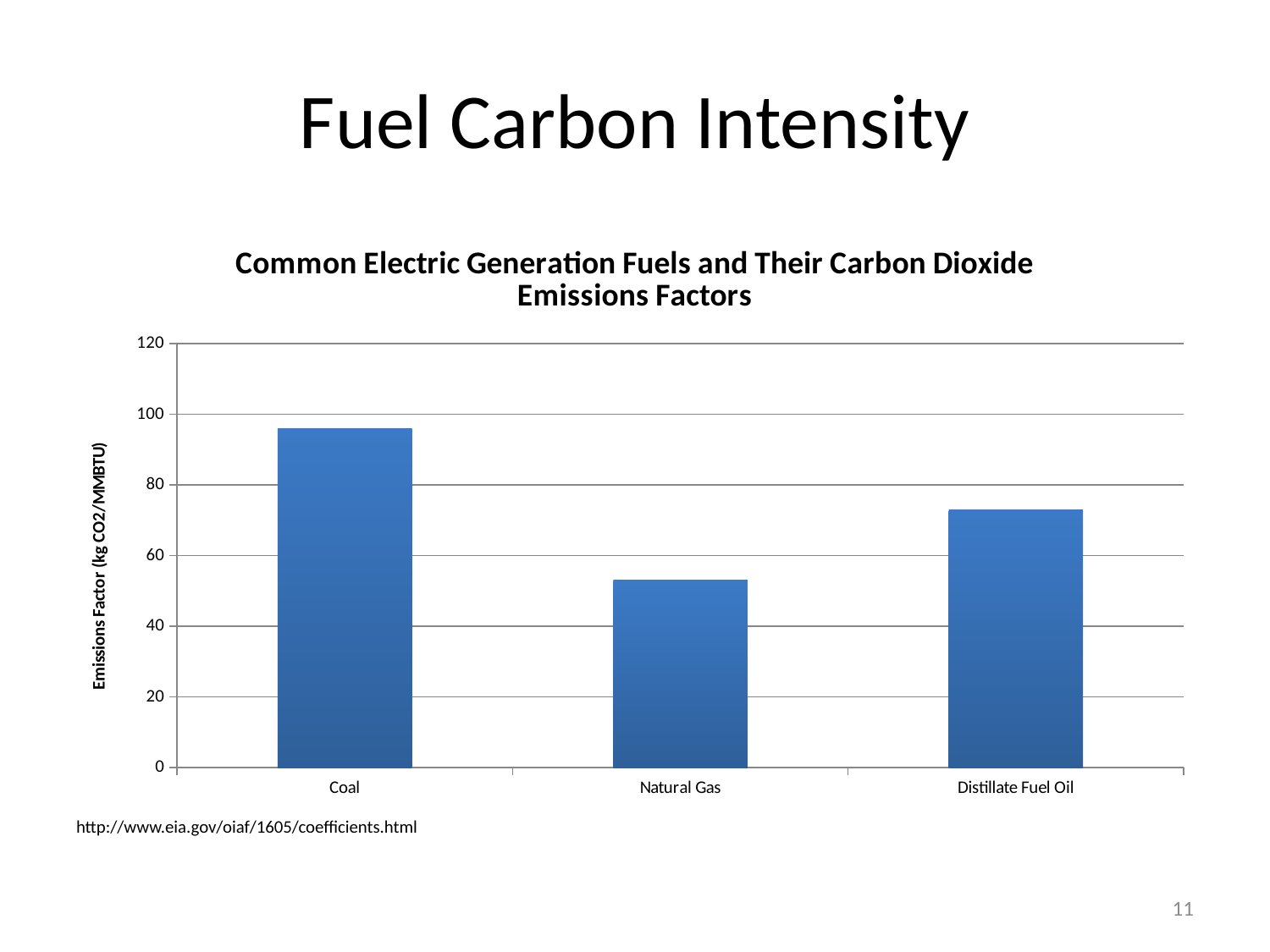
Which has a larger emissions factor, Natural Gas or Distillate Fuel Oil? Distillate Fuel Oil What kind of chart is shown on the slide? bar chart Is the value for Coal greater or less than 80? greater Is the value for Natural Gas greater or less than 60? less What is the label of the vertical axis? Emissions Factor (kg CO2/MMBTU) Is the value for Coal greater or less than 100? less Which fuel has the highest emissions factor? Coal Which has a larger emissions factor, Coal or Distillate Fuel Oil? Coal How many fuel categories are plotted on the chart? 3 Which fuel has the lowest emissions factor? Natural Gas What is the title of the chart? Common Electric Generation Fuels and Their Carbon Dioxide Emissions Factors